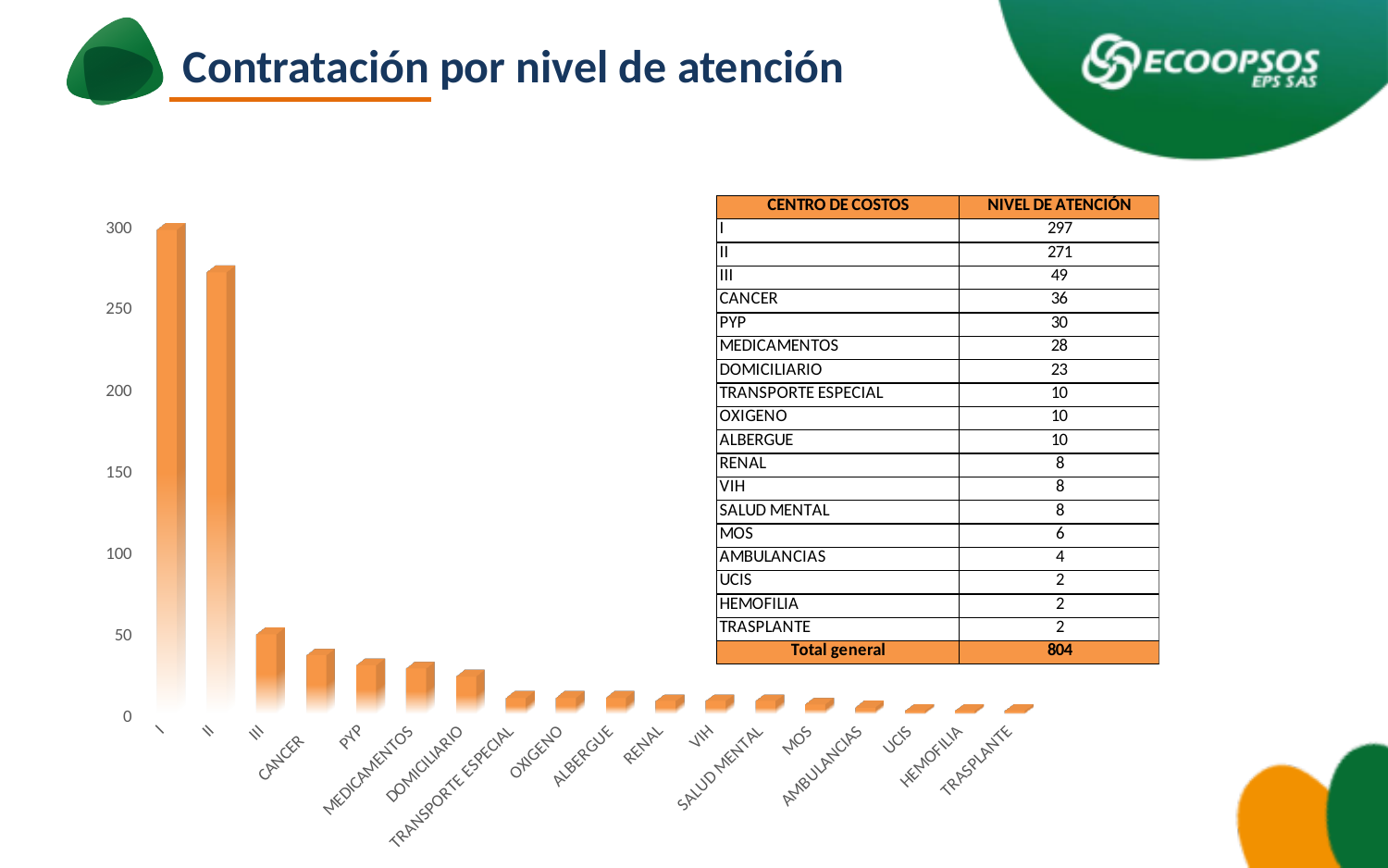
How many categories are plotted along the x axis of the chart? 18 According to the table on the slide, what is the value for DOMICILIARIO? 23 Which is larger in the chart, the bar for III or the bar for PYP? III Using the values in the table, what is the difference between I and II? 26 Is the value for III greater or less than 100? less Is the value for II greater or less than 250? greater What type of chart is shown on the slide? bar chart Which category has the highest bar in the chart? I According to the table on the slide, what is the value for CANCER? 36 What is the Total general shown in the table on the slide? 804 Do the bar heights rise or fall moving from left to right along the x axis? fall According to the table on the slide, what is the value for MEDICAMENTOS? 28